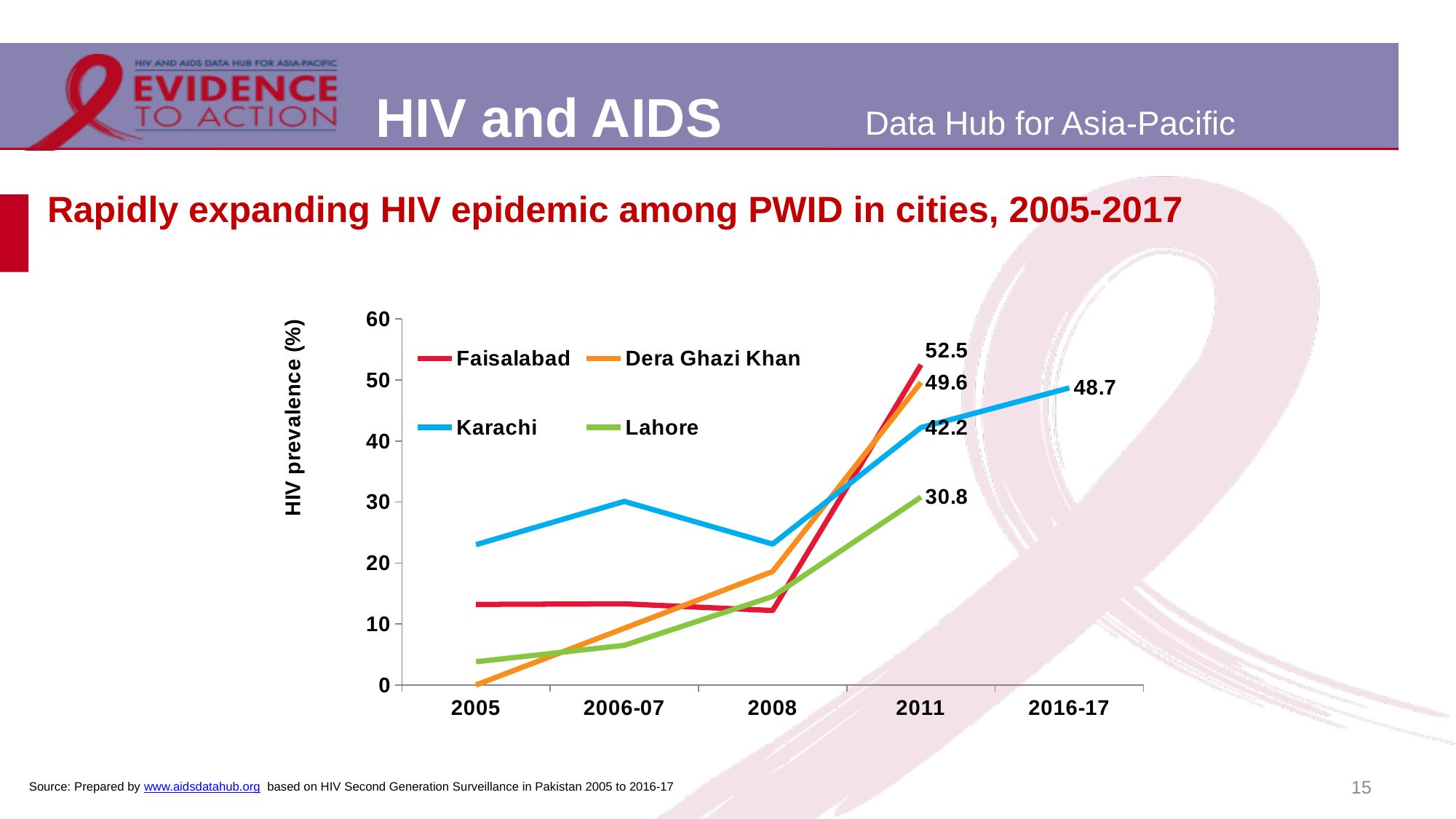
What is the difference between the 2011 HIV prevalence values for Faisalabad and Lahore? 21.7 In 2011, which has the higher HIV prevalence: Faisalabad or Dera Ghazi Khan? Faisalabad What is the HIV prevalence (%) for Faisalabad in 2011? 52.5 By how much did Karachi's HIV prevalence increase from 2011 to 2016-17? 6.5 What is the HIV prevalence (%) for Lahore in 2011? 30.8 Which city has the highest HIV prevalence in 2011? Faisalabad How many cities (series) does the legend list? 4 What is the HIV prevalence (%) for Karachi in 2016-17? 48.7 Which city has the lowest HIV prevalence in 2011? Lahore Is the HIV prevalence for Karachi in 2005 greater or less than 20? greater What is the HIV prevalence (%) for Dera Ghazi Khan in 2011? 49.6 What kind of chart is shown on the slide? line chart